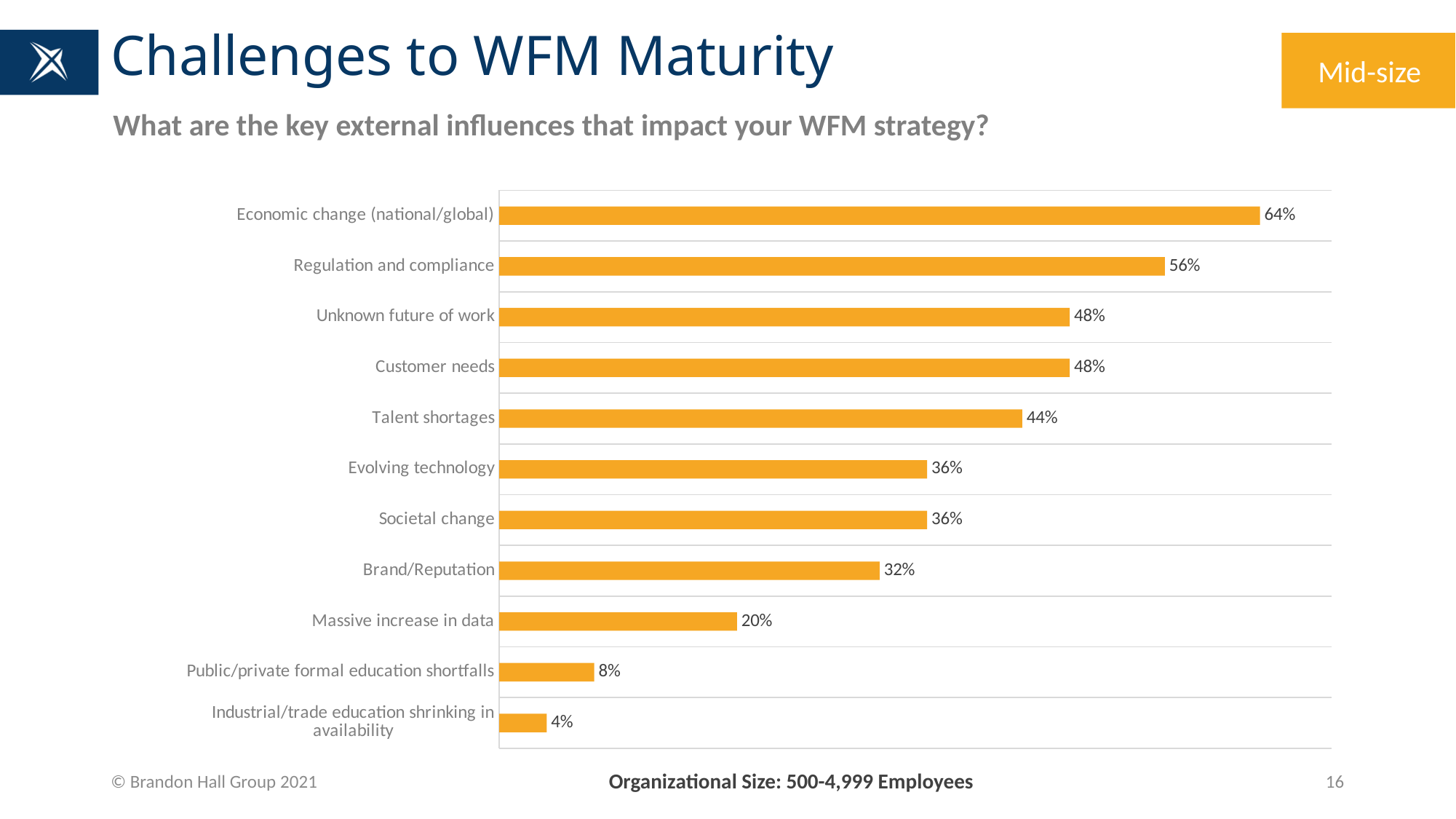
Which is larger, the value for Evolving technology or the value for Brand/Reputation? Evolving technology Which category has the highest value? Economic change (national/global) What kind of chart is shown on the slide? Bar chart Which category has the lowest value? Industrial/trade education shrinking in availability What is the value for Regulation and compliance? 56% What is the value for Massive increase in data? 20% What percentage is shown for Talent shortages? 44% How many categories are shown in the chart? 11 What is the difference between the values for Economic change (national/global) and Regulation and compliance? 8% What question does the chart answer, as stated in the subtitle? What are the key external influences that impact your WFM strategy? What percentage is shown for Economic change (national/global)? 64% What is the difference between the values for Brand/Reputation and Public/private formal education shortfalls? 24%